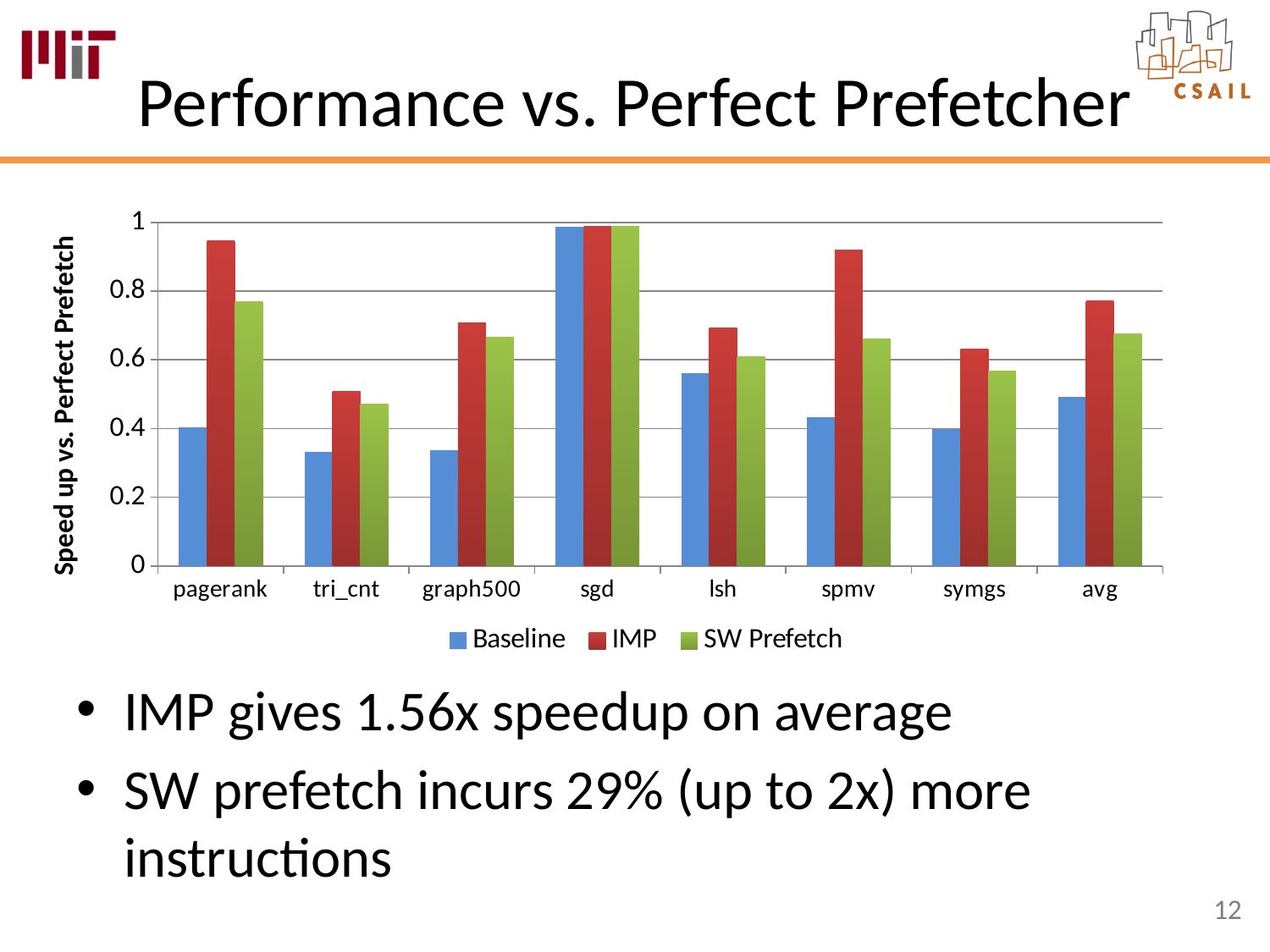
Is the IMP value for avg greater or less than 0.6? greater Is the SW Prefetch value for tri_cnt greater or less than 0.6? less What kind of chart is shown on the slide? bar chart Which is larger: the Baseline value for lsh or the Baseline value for spmv? lsh What is the title of the chart's y axis? Speed up vs. Perfect Prefetch Is the Baseline value for pagerank greater or less than 0.6? less Which category has the highest SW Prefetch value? sgd For spmv, which is larger: the IMP value or the SW Prefetch value? IMP Which category has the lowest IMP value? tri_cnt How many series does the chart's legend list? 3 How many categories are shown along the x axis of the chart? 8